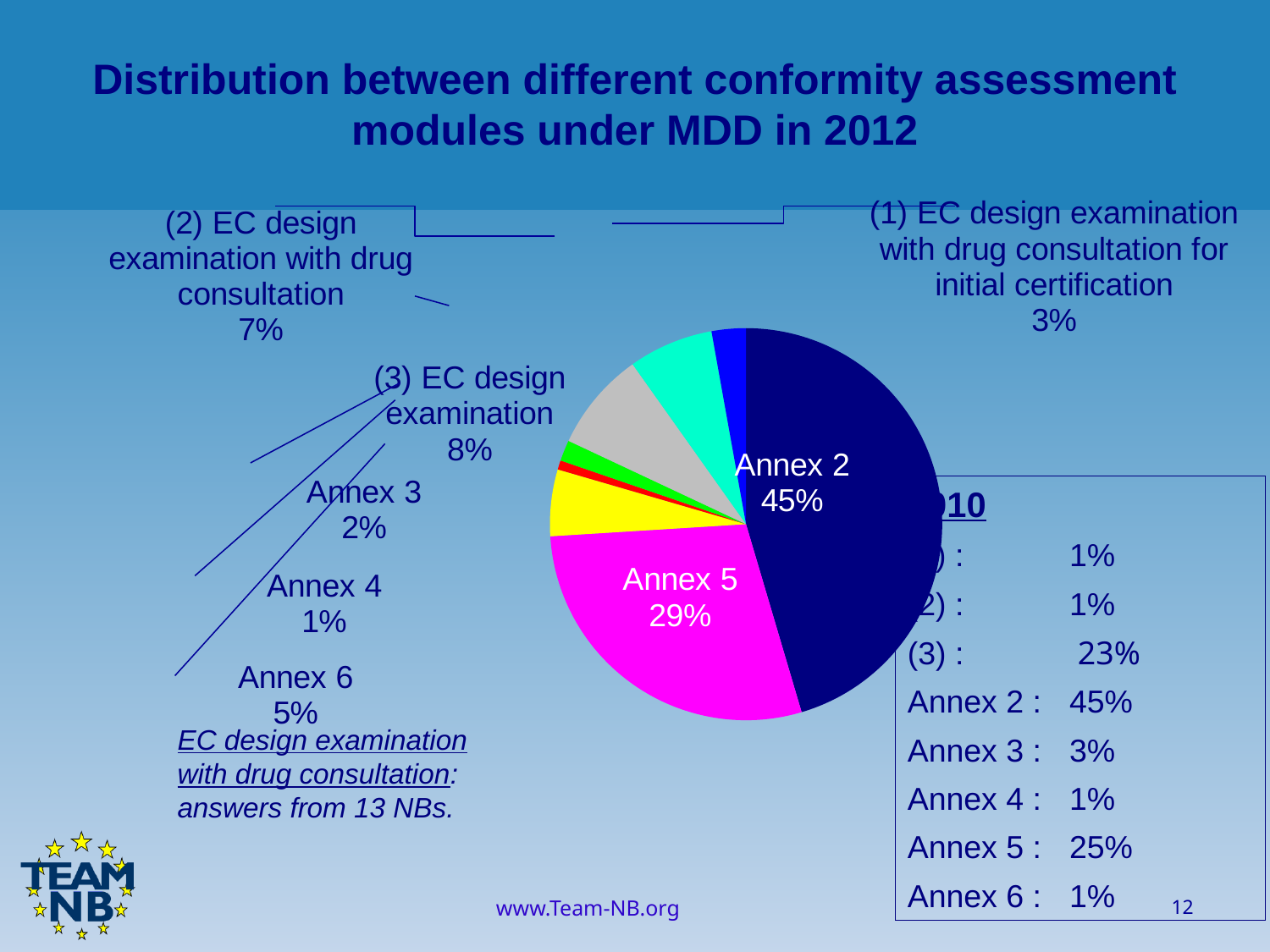
What percentage is shown for (3) EC design examination? 8% What percentage is shown for (1) EC design examination with drug consultation for initial certification? 3% What percentage is shown for Annex 6? 5% Which is larger, the share for Annex 3 or the share for Annex 6? Annex 6 What share of the pie does Annex 5 represent? 29% What share of the pie does Annex 2 represent? 45% What percentage is shown for (2) EC design examination with drug consultation? 7% What type of chart is shown on the slide? pie chart Which category has the largest slice of the pie? Annex 2 What is the difference in percentage points between Annex 2 and Annex 5? 16% How many slices does the pie chart have? 8 Which category has the smallest slice of the pie? Annex 4